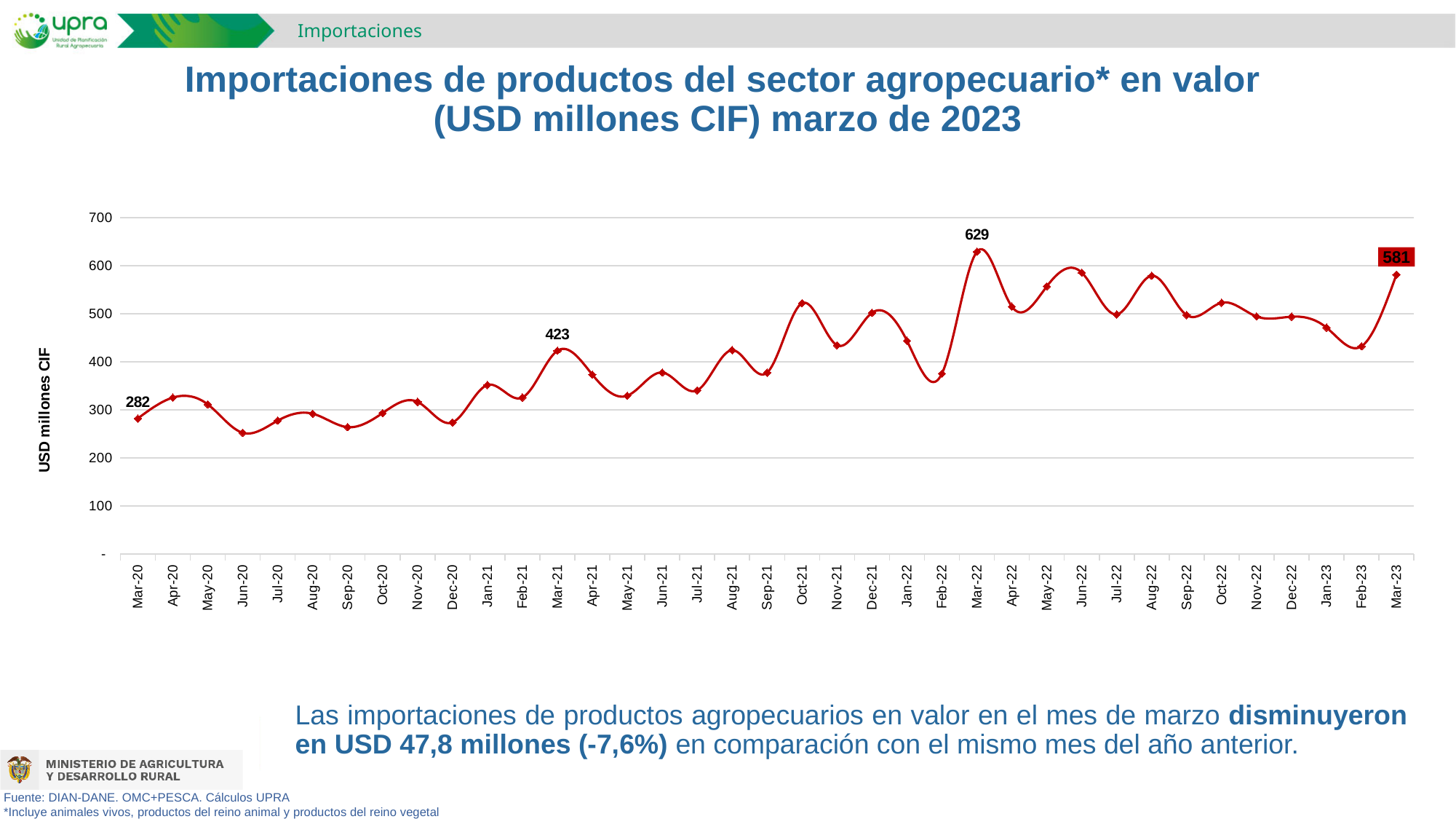
What is the difference between the values for Mar-22 and Mar-21? 206 How many monthly data points are plotted on the chart? 37 Which month has the highest value on the chart? Mar-22 Which is larger, the value for Mar-22 or the value for Mar-23? Mar-22 What is the title of the vertical axis? USD millones CIF What kind of chart is shown on the slide? line chart Is the value for Oct-21 greater or less than 500? greater What is the value for Mar-21? 423 What is the value for Mar-23? 581 Is the value for Jun-20 greater or less than 300? less What is the value for Mar-20? 282 What is the value for Mar-22? 629